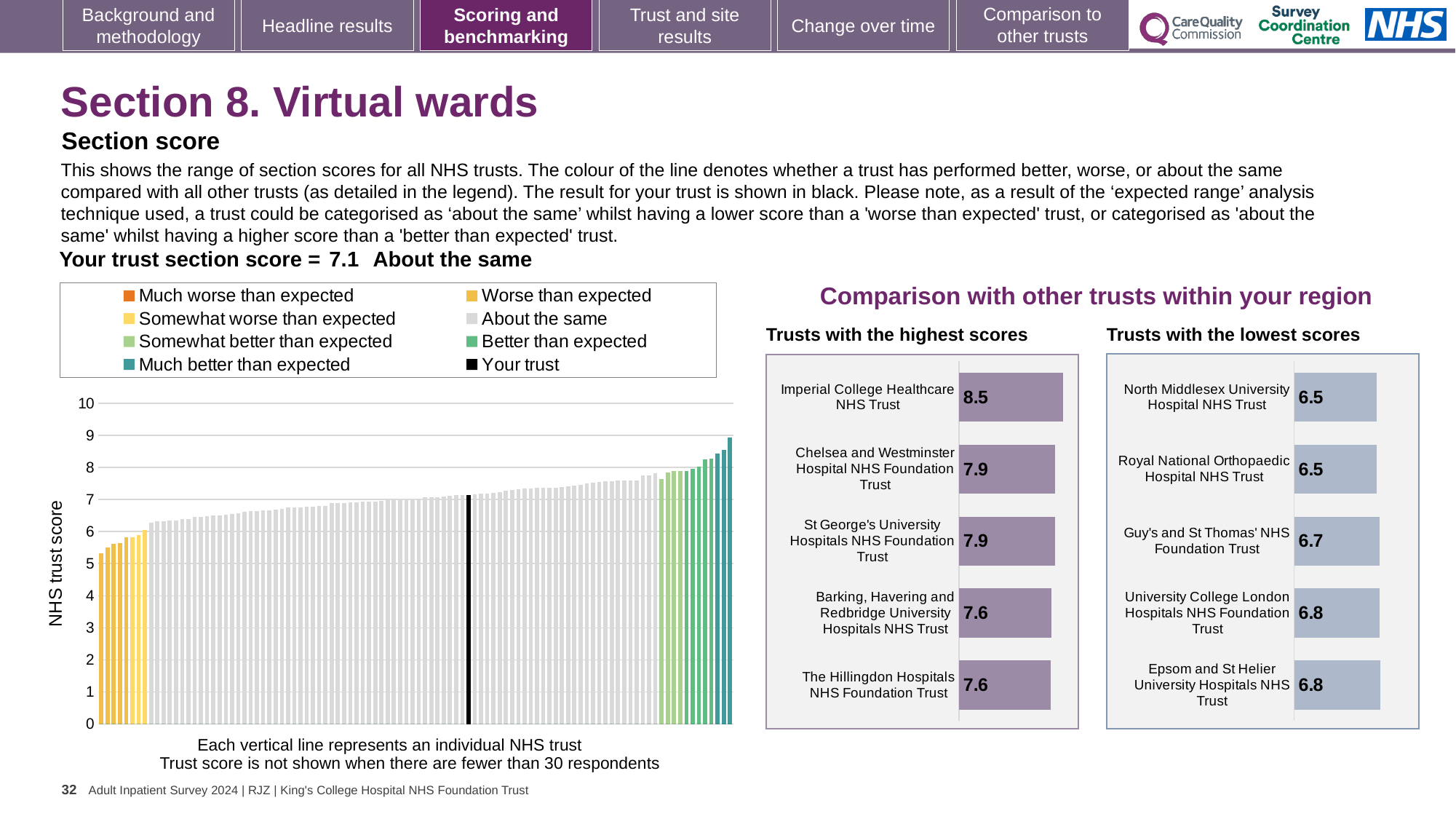
In the large chart of NHS trust scores on the left, what is the section score for your trust? 7.1 In the 'Trusts with the lowest scores' chart, what is the score for Guy's and St Thomas' NHS Foundation Trust? 6.7 How many trusts are shown in the 'Trusts with the highest scores' chart? 5 In the 'Trusts with the lowest scores' chart, what is the score for Epsom and St Helier University Hospitals NHS Trust? 6.8 In the 'Trusts with the highest scores' chart, which trust has the highest score? Imperial College Healthcare NHS Trust In the 'Trusts with the highest scores' chart, what is the score for The Hillingdon Hospitals NHS Foundation Trust? 7.6 In the 'Trusts with the highest scores' chart, what is the difference between the scores of Imperial College Healthcare NHS Trust and The Hillingdon Hospitals NHS Foundation Trust? 0.9 How many entries does the legend of the large chart on the left list? 8 In the large chart of NHS trust scores on the left, do the values rise or fall from left to right? rise In the 'Trusts with the lowest scores' chart, what is the difference between the scores of Guy's and St Thomas' NHS Foundation Trust and North Middlesex University Hospital NHS Trust? 0.2 In the 'Trusts with the lowest scores' chart, which is larger: the score for University College London Hospitals NHS Foundation Trust or Guy's and St Thomas' NHS Foundation Trust? University College London Hospitals NHS Foundation Trust In the 'Trusts with the highest scores' chart, what is the score for Imperial College Healthcare NHS Trust? 8.5